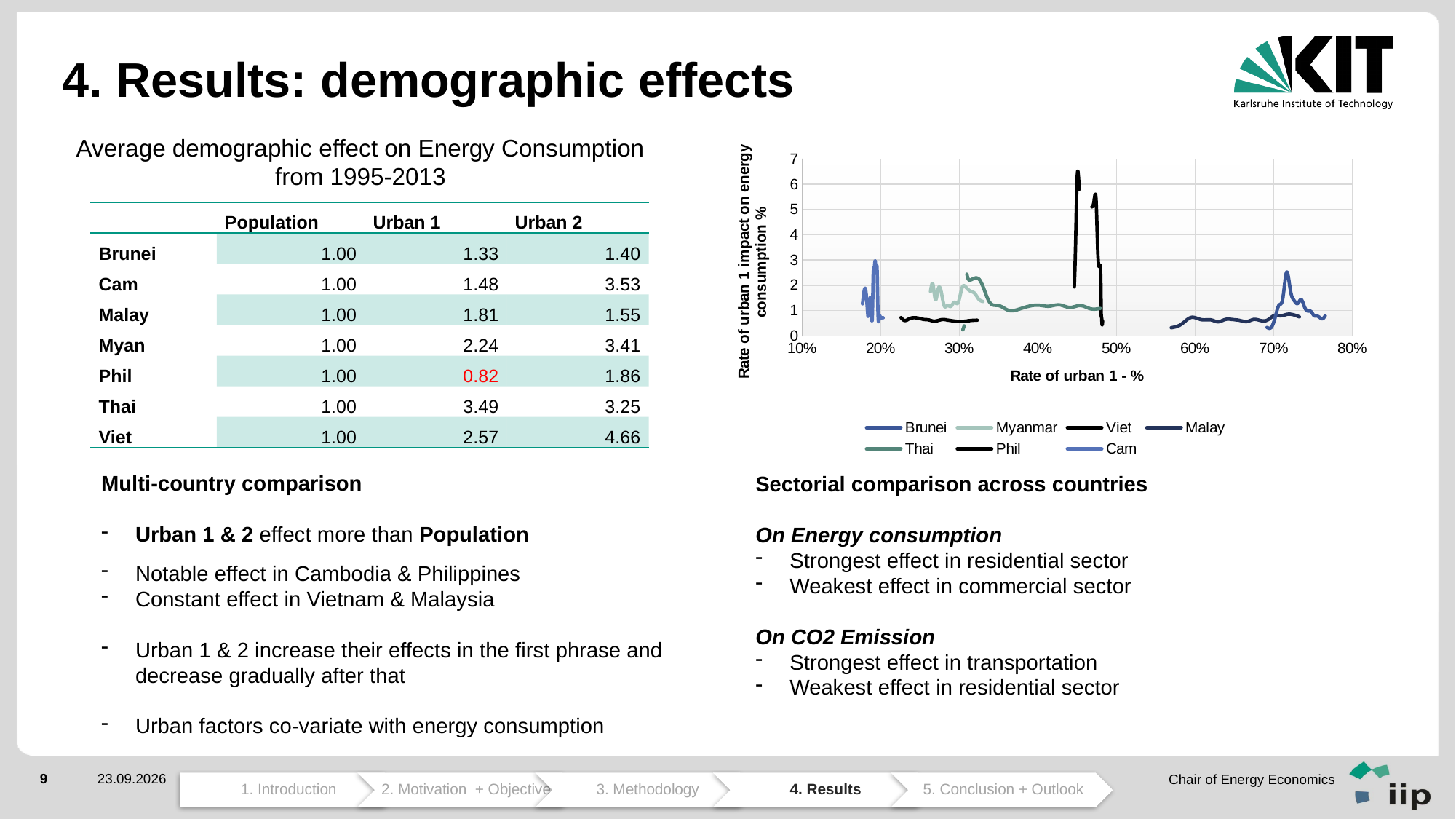
In the line chart, is the highest peak of any series greater or less than 6? greater How many series does the legend of the line chart list? 7 How many tick labels are shown on the x axis of the line chart? 8 What is the highest value labelled on the y axis of the line chart? 7 What kind of chart is shown on the right side of the slide? line chart What is the highest value labelled on the x axis of the line chart? 80% What is the title of the x axis of the line chart? Rate of urban 1 - % In the line chart, is the highest peak of any series greater or less than 7? less What is the lowest value labelled on the x axis of the line chart? 10% What is the title of the y axis of the line chart? Rate of urban 1 impact on energy consumption %